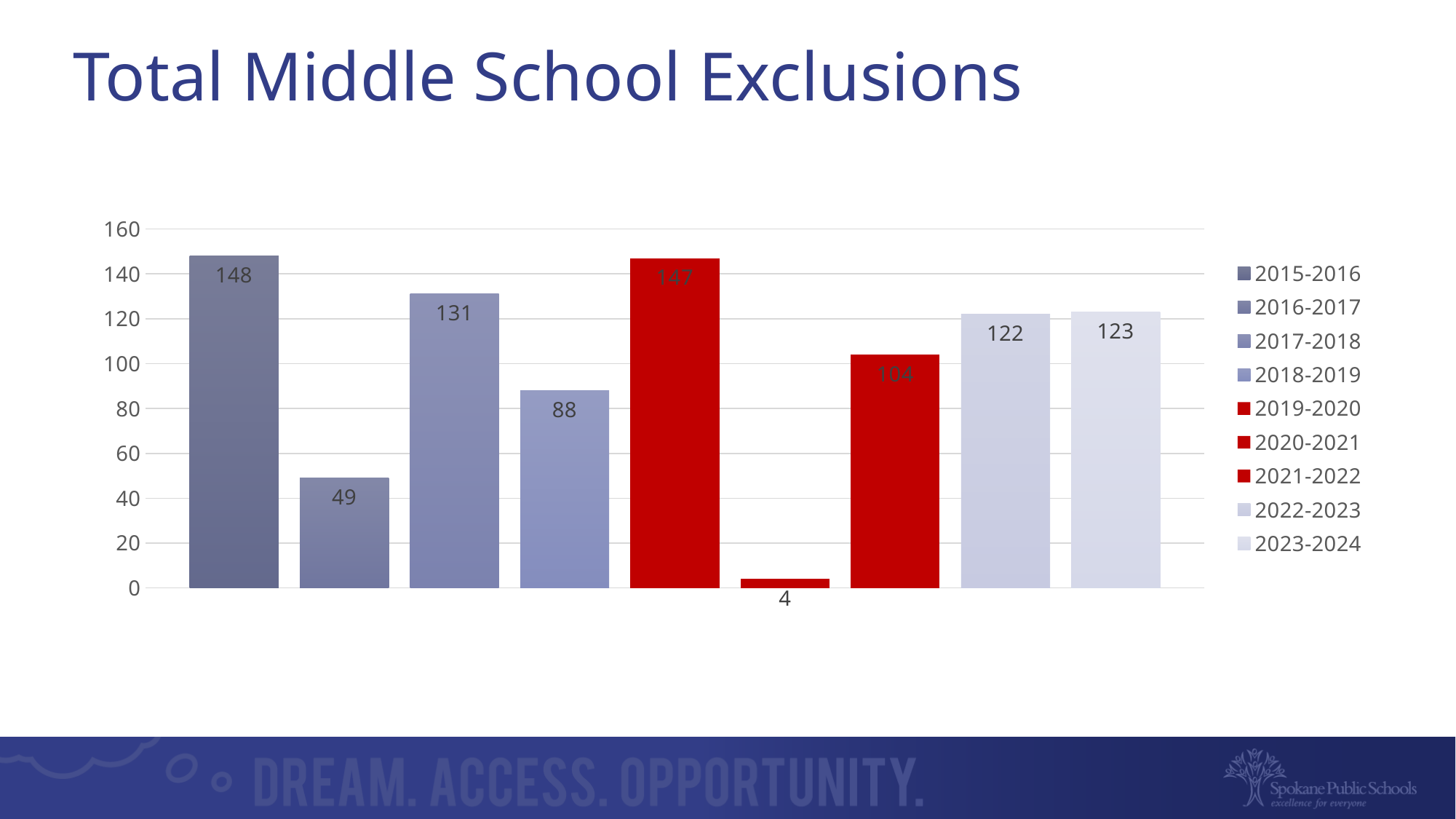
What is the title of the chart? Total Middle School Exclusions Is the value for 2016-2017 greater or less than 60? less Which school year has the highest total middle school exclusions? 2015-2016 How many school years are plotted in the chart? 9 What is the value for 2020-2021? 4 What kind of chart is shown on the slide? bar chart What is the value for 2015-2016? 148 How many entries does the legend list? 9 Which school year has the lowest total middle school exclusions? 2020-2021 Which is larger, the value for 2017-2018 or the value for 2018-2019? 2017-2018 What is the difference between the values for 2019-2020 and 2021-2022? 43 What is the value for 2023-2024? 123